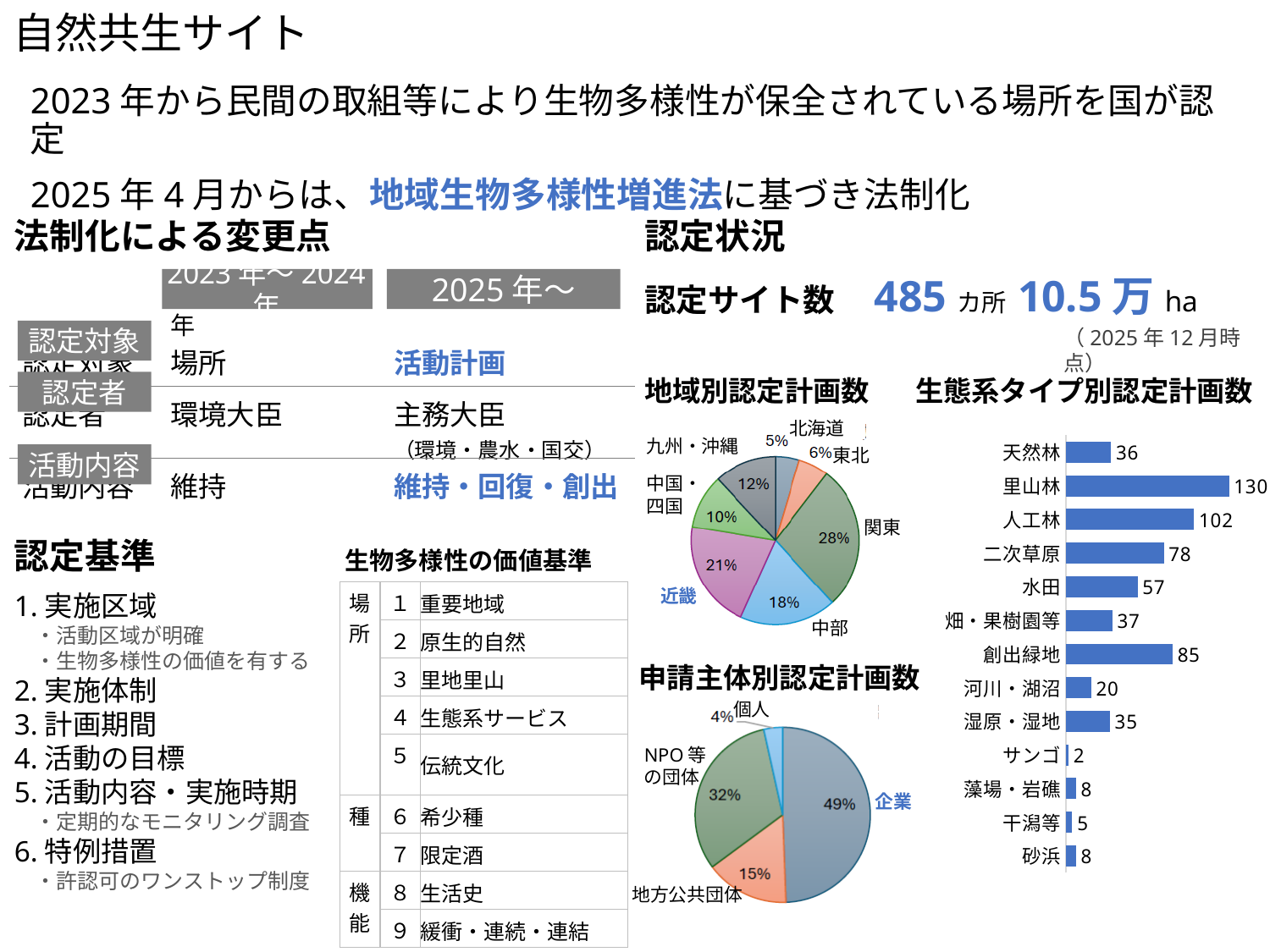
In the 生態系タイプ別認定計画数 chart, what is the value for 里山林? 130 In the 地域別認定計画数 pie chart, what share does 関東 have? 28% In the 生態系タイプ別認定計画数 chart, which category has the highest value? 里山林 In the 生態系タイプ別認定計画数 chart, what is the difference between 人工林 and 二次草原? 24 In the 地域別認定計画数 pie chart, which region has the smallest share? 北海道 What kind of chart is the 生態系タイプ別認定計画数 chart? bar chart What kind of chart is the 申請主体別認定計画数 chart? pie chart In the 生態系タイプ別認定計画数 chart, which category has the lowest value? サンゴ In the 生態系タイプ別認定計画数 chart, which is larger, 水田 or 創出緑地? 創出緑地 In the 申請主体別認定計画数 pie chart, what share does 企業 have? 49% In the 申請主体別認定計画数 pie chart, what is the difference between the shares of NPO等の団体 and 地方公共団体? 17% In the 生態系タイプ別認定計画数 chart, how many categories are shown? 13